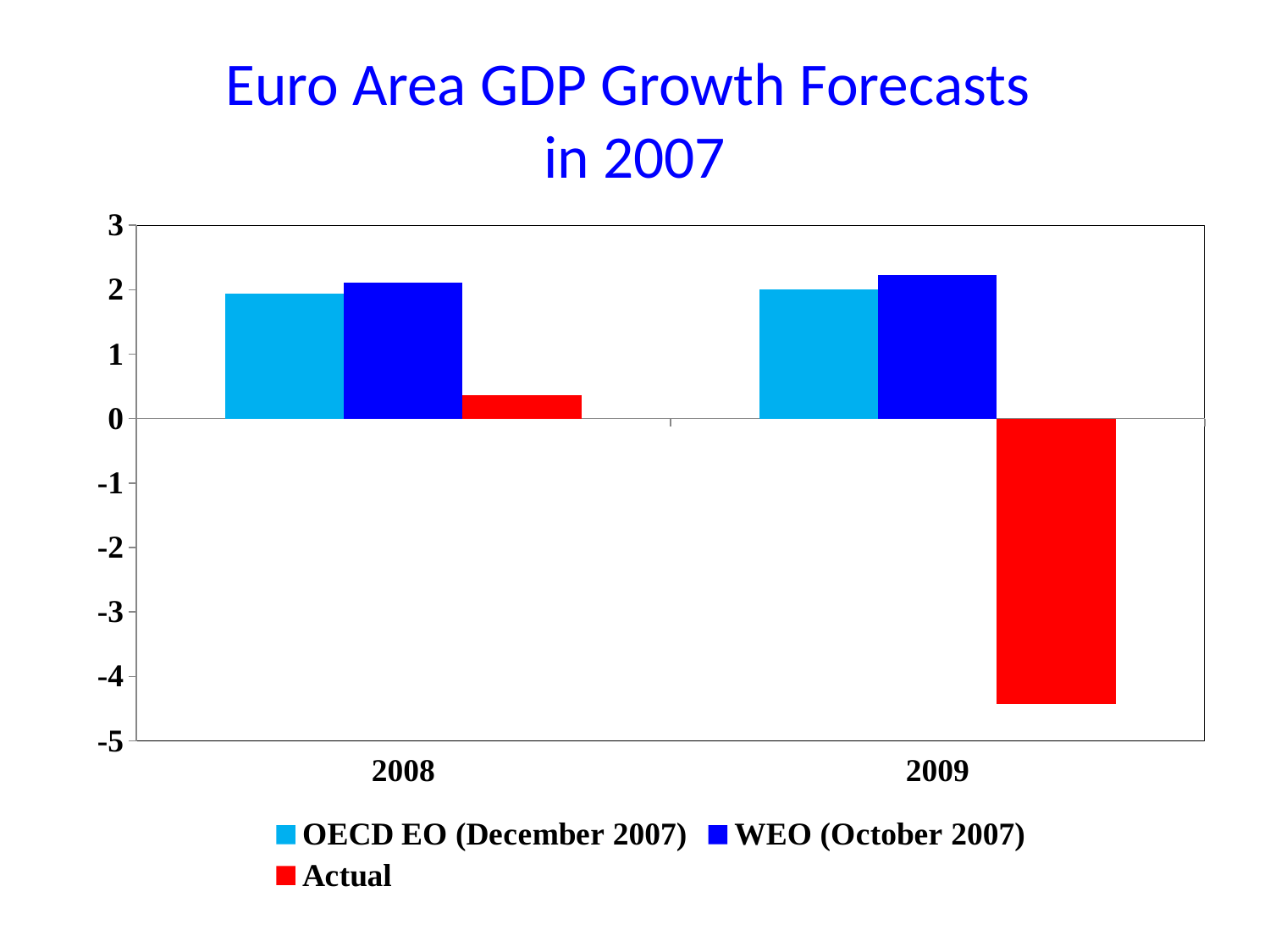
How many series does the legend list? 3 How many year categories are shown on the x axis? 2 Does the Actual value rise or fall from 2008 to 2009? fall Which series has the highest value in 2009? WEO (October 2007) Which is larger for 2008, the WEO (October 2007) forecast or the Actual value? WEO (October 2007) What is the title of the chart? Euro Area GDP Growth Forecasts in 2007 Is the Actual value for 2008 greater or less than 1? less Is the OECD EO (December 2007) value for 2008 greater or less than 1? greater Which series has the lowest value in 2009? Actual Is the Actual value for 2009 greater or less than -4? less What kind of chart is shown on the slide? bar chart